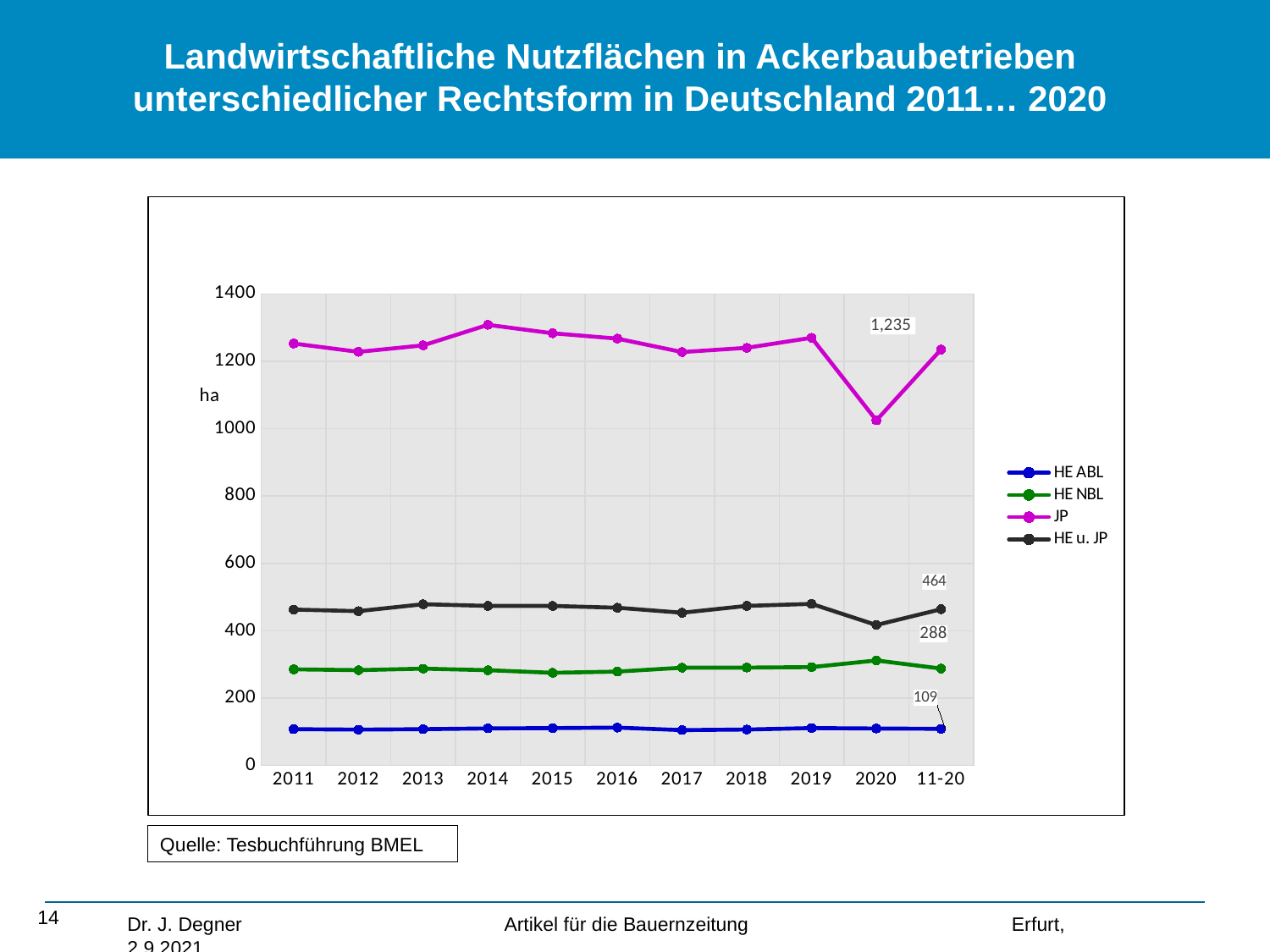
How many categories are shown on the x axis? 11 What is the value for HE ABL at 11-20? 109 What is the difference between the JP value and the HE u. JP value at 11-20? 771 What is the value for JP at 11-20? 1,235 What kind of chart is shown on the slide? line chart In which year is the JP series at its lowest? 2020 Which series has the larger value at 11-20, HE NBL or HE ABL? HE NBL What unit is shown on the y axis? ha What is the value for HE NBL at 11-20? 288 How many series does the legend list? 4 What is the value for HE u. JP at 11-20? 464 Is the value for JP in 2020 greater or less than 1200? less